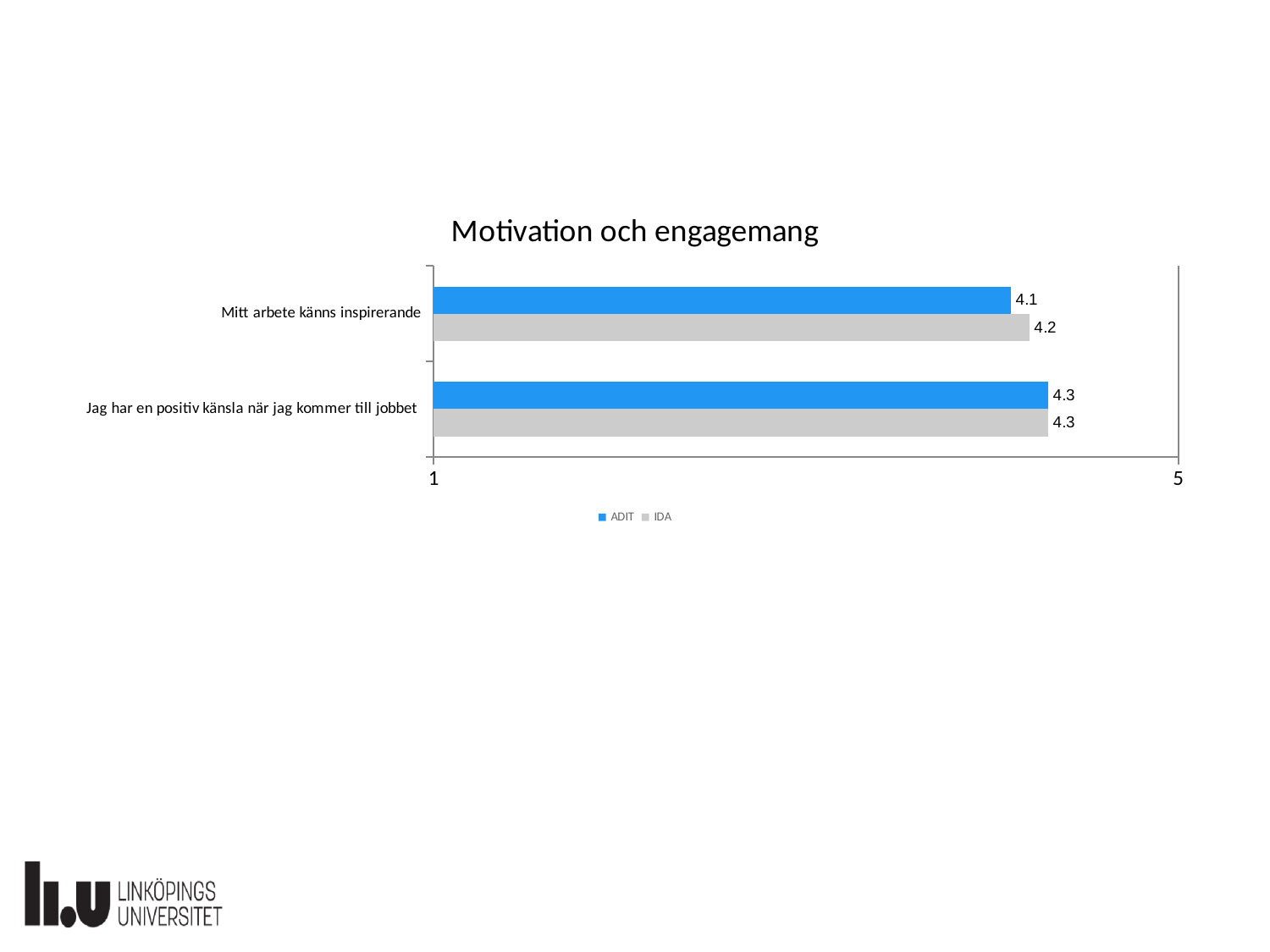
How many categories are shown on the chart? 2 How many series does the legend list? 2 What is the IDA value for "Jag har en positiv känsla när jag kommer till jobbet"? 4.3 What is the title of the chart? Motivation och engagemang What is the ADIT value for "Jag har en positiv känsla när jag kommer till jobbet"? 4.3 What is the ADIT value for "Mitt arbete känns inspirerande"? 4.1 Which series has the higher value for "Mitt arbete känns inspirerande", ADIT or IDA? IDA What type of chart is shown on the slide? bar chart Which series is shown in blue in the legend? ADIT What is the difference between the IDA and ADIT values for "Mitt arbete känns inspirerande"? 0.1 Which category has the lowest ADIT value? Mitt arbete känns inspirerande What is the IDA value for "Mitt arbete känns inspirerande"? 4.2